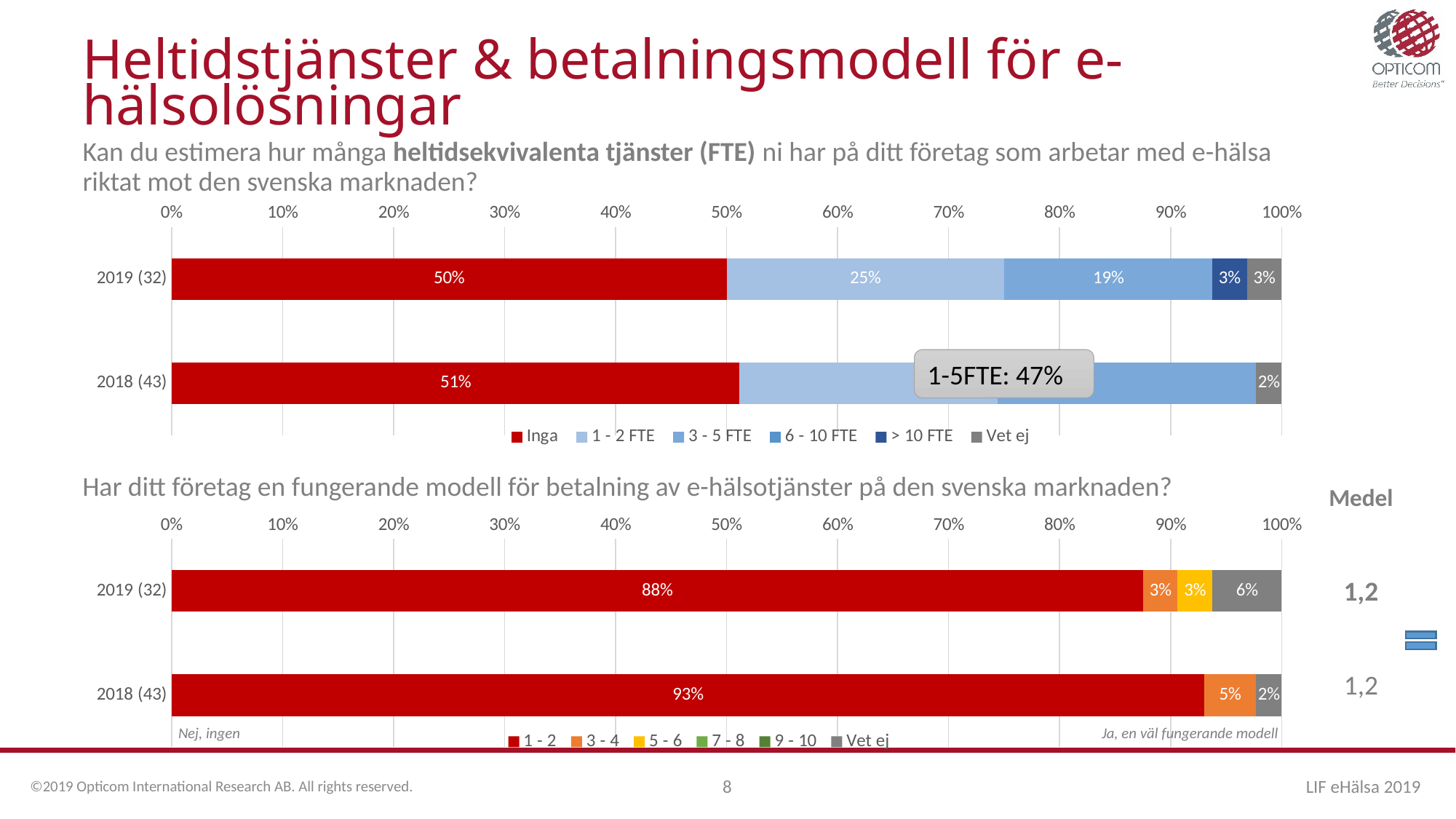
In the top chart (FTE question), what percentage of 2019 (32) respondents answered "Inga"? 50% In the top chart (FTE question), what percentage of 2019 (32) respondents answered "3 - 5 FTE"? 19% In the top chart (FTE question), what percentage of 2018 (43) respondents answered "Inga"? 51% In the bottom chart (payment model question), what is the Medel (mean) value shown for 2019 (32)? 1,2 In the bottom chart (payment model question), what is the difference between the "1 - 2" share in 2018 (43) and in 2019 (32)? 5 percentage points In the top chart (FTE question), how many series does the legend list? 6 In the top chart (FTE question), what percentage of 2019 (32) respondents answered "1 - 2 FTE"? 25% In the bottom chart (payment model question), what percentage of 2019 (32) respondents answered "1 - 2"? 88% In the bottom chart (payment model question), what percentage of 2019 (32) respondents answered "Vet ej"? 6% In the bottom chart (payment model question), what percentage of 2018 (43) respondents answered "1 - 2"? 93% What type of chart is used for the bottom chart (payment model question)? Stacked horizontal bar chart In the top chart (FTE question), what combined share does the callout give for 1-5 FTE in 2018 (43)? 47%